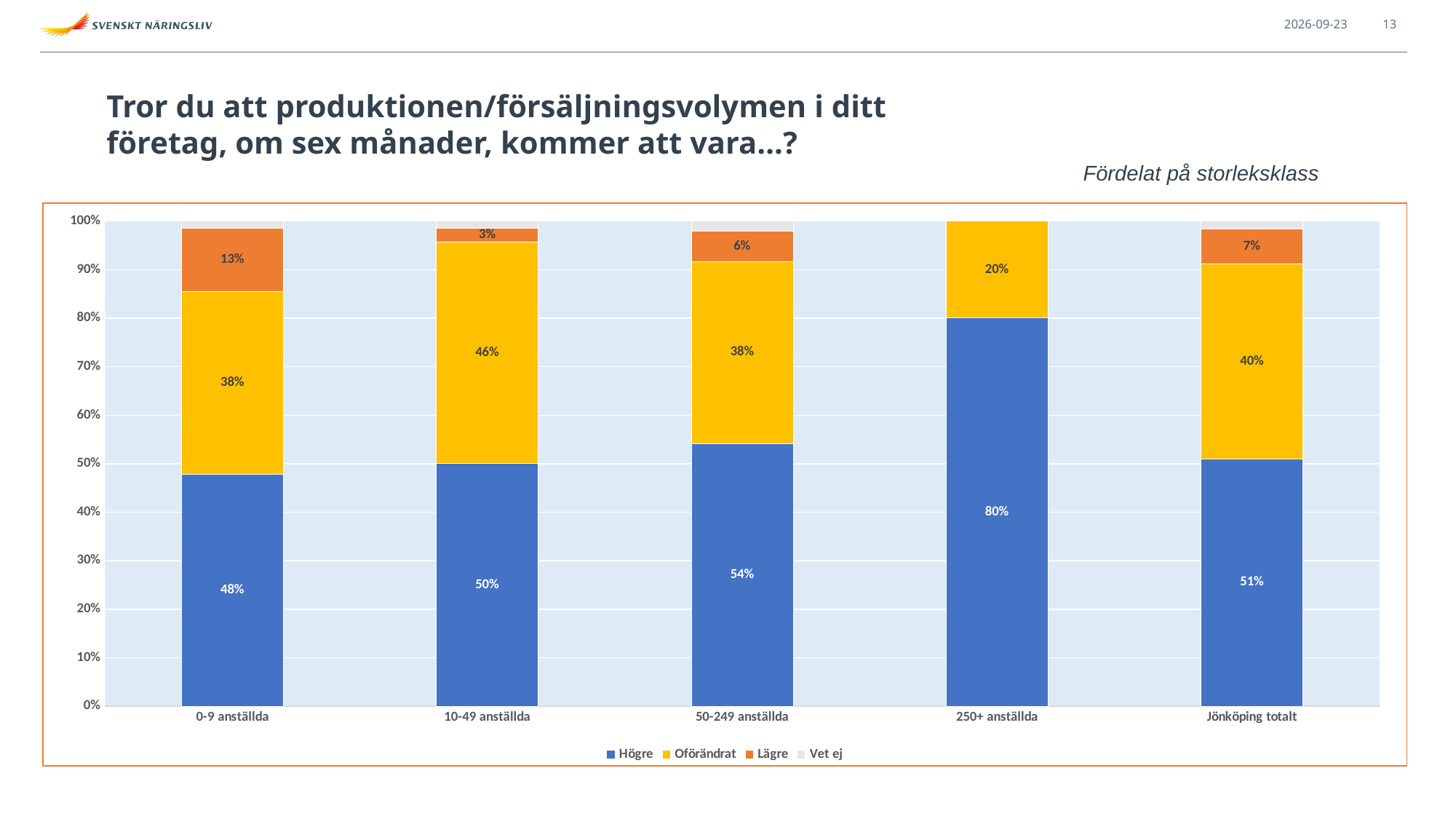
How many categories are shown on the x axis? 5 What is the Lägre value for Jönköping totalt? 7% How many series does the legend list? 4 What is the Oförändrat value for 10-49 anställda? 46% Is the Vet ej value for 50-249 anställda greater or less than 10%? less What is the difference in percentage points between the Högre value for 250+ anställda and the Högre value for 0-9 anställda? 32 percentage points Which category has the highest Lägre share? 0-9 anställda What percentage of companies with 0-9 anställda answered Högre? 48% What is the Högre value for 250+ anställda? 80% Which category has the highest Högre share? 250+ anställda What kind of chart is shown on the slide? Stacked bar chart Which is larger: the Oförändrat value for 10-49 anställda or for 0-9 anställda? 10-49 anställda